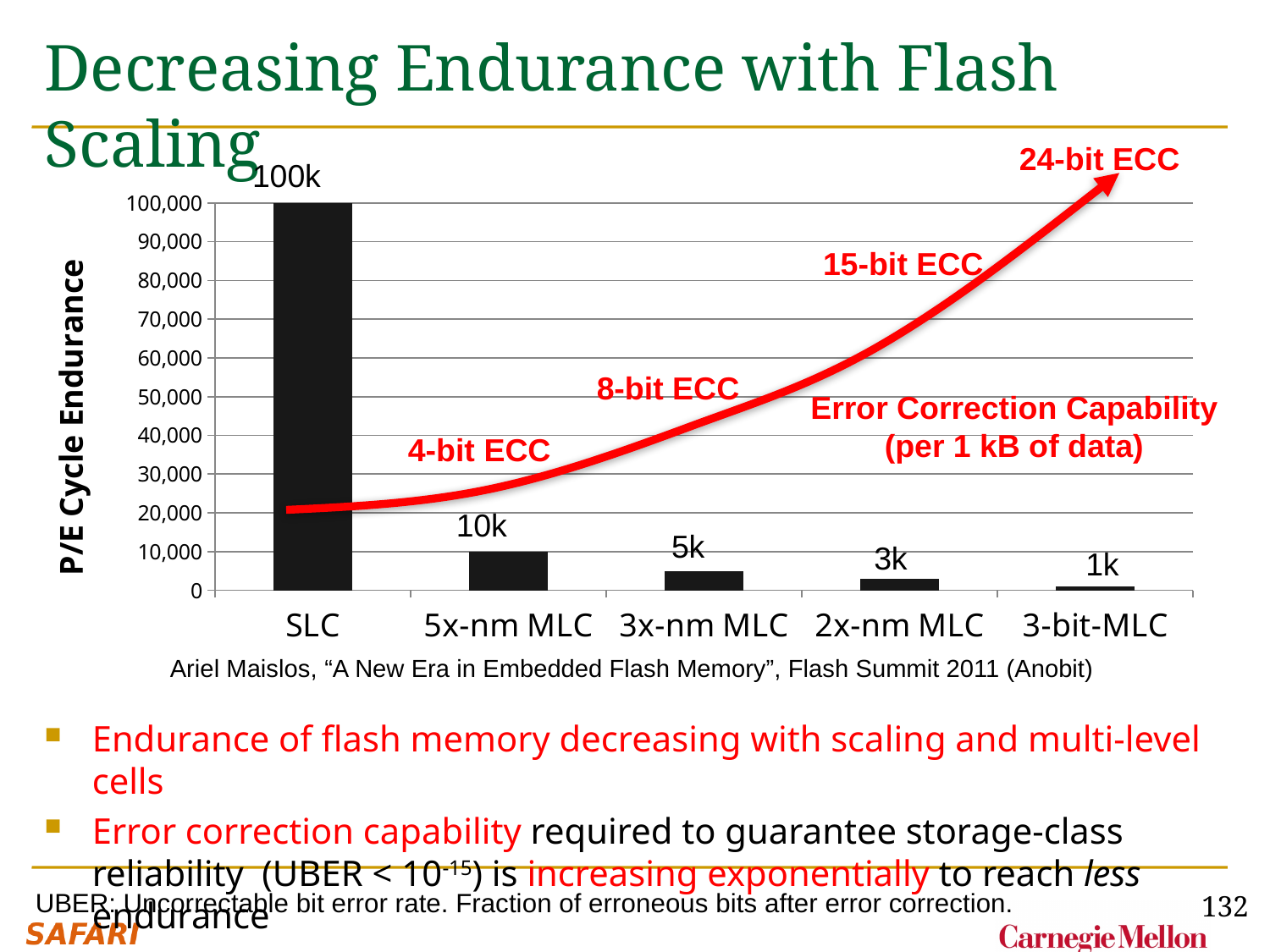
What is the P/E cycle endurance shown for SLC? 100k What is the P/E cycle endurance shown for 2x-nm MLC? 3k What kind of chart is used to show P/E cycle endurance? Bar chart What is the P/E cycle endurance shown for 5x-nm MLC? 10k What is the difference in P/E cycle endurance between SLC and 5x-nm MLC? 90k Which category has the highest P/E cycle endurance? SLC Do the P/E cycle endurance values rise or fall moving from left to right along the x axis? Fall What is the P/E cycle endurance shown for 3-bit-MLC? 1k What is the difference in P/E cycle endurance between 3x-nm MLC and 2x-nm MLC? 2k Which has a higher P/E cycle endurance, 3x-nm MLC or 3-bit-MLC? 3x-nm MLC How many categories are shown on the x axis of the bar chart? 5 Which category has the lowest P/E cycle endurance? 3-bit-MLC